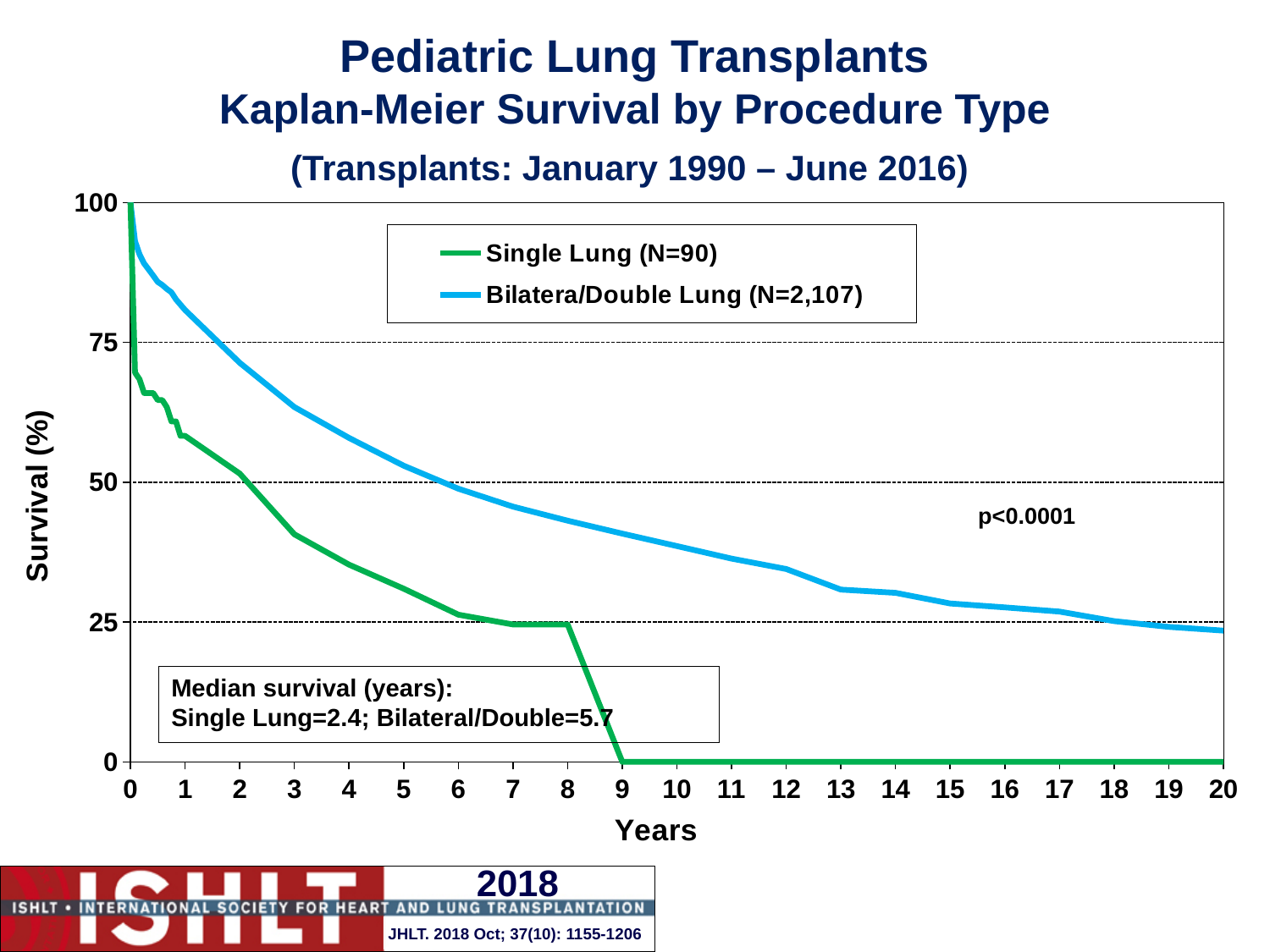
Is the survival for Single Lung at 3 years greater or less than 50%? less What is the N for the Bilateral/Double Lung series in the legend? 2,107 At 5 years, which series has the higher survival, Single Lung or Bilateral/Double Lung? Bilateral/Double Lung Do the survival curves rise or fall as years increase? fall What kind of chart is shown on the slide? line chart Is the survival for Bilateral/Double Lung at 3 years greater or less than 50%? greater What p-value is printed on the chart? p<0.0001 Is the survival for Bilateral/Double Lung at 10 years greater or less than 25%? greater How many series does the legend list? 2 What is the median survival in years for Single Lung transplants? 2.4 What is the median survival in years for Bilateral/Double Lung transplants? 5.7 What is the N for the Single Lung series in the legend? 90